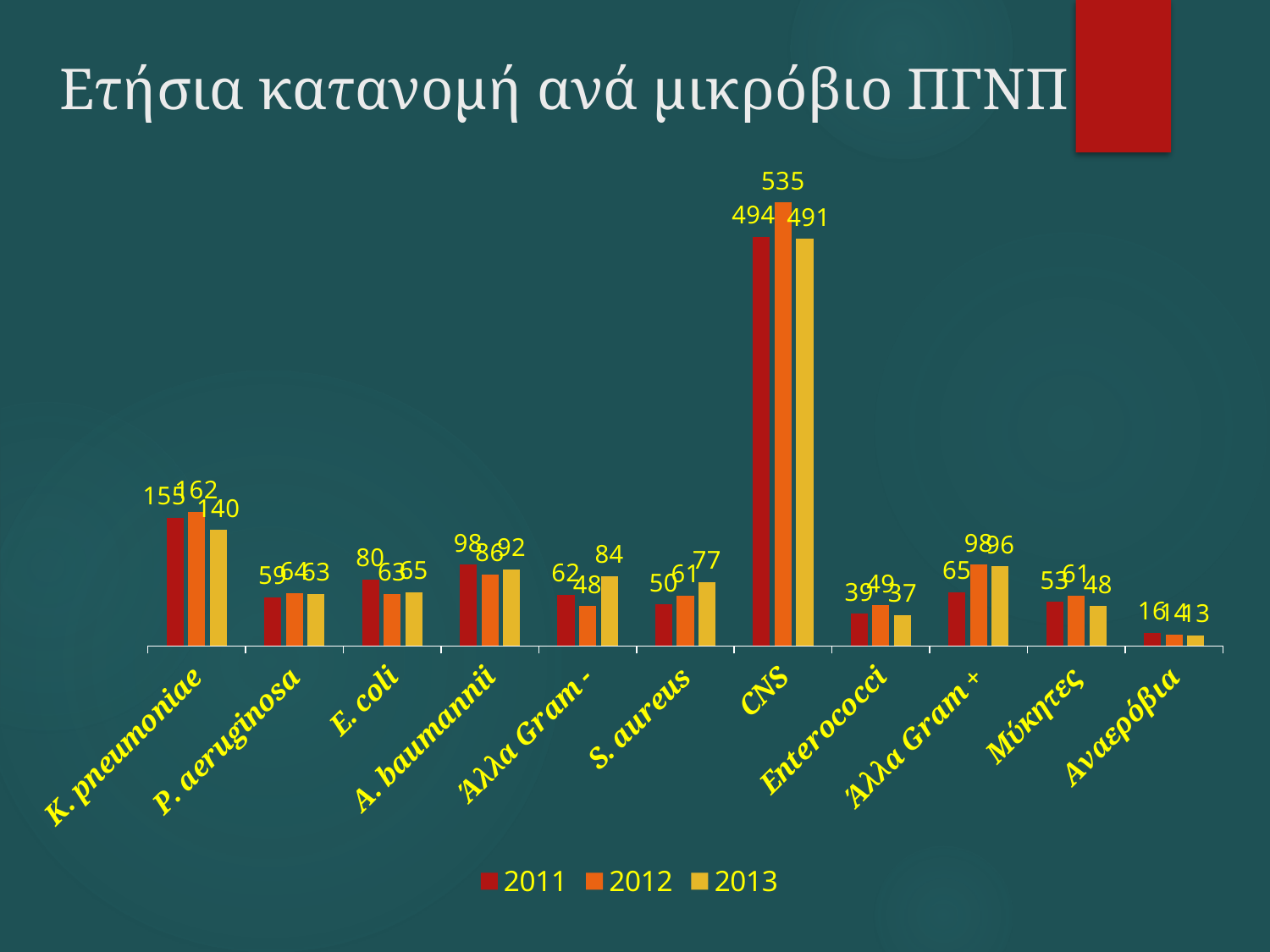
Which is larger in 2011: E. coli or S. aureus? E. coli What is the value for CNS in 2012? 535 Which category has the lowest value in 2013? Αναερόβια Which category has the highest value in 2012? CNS What is the value for K. pneumoniae in 2013? 140 What is the value for CNS in 2011? 494 What is the difference between the CNS values for 2012 and 2011? 41 How many series does the legend list? 3 What kind of chart is shown on the slide? bar chart What is the value for Άλλα Gram - in 2013? 84 How many microbe categories are shown on the x axis? 11 Do the values for S. aureus rise or fall from 2011 to 2013? rise